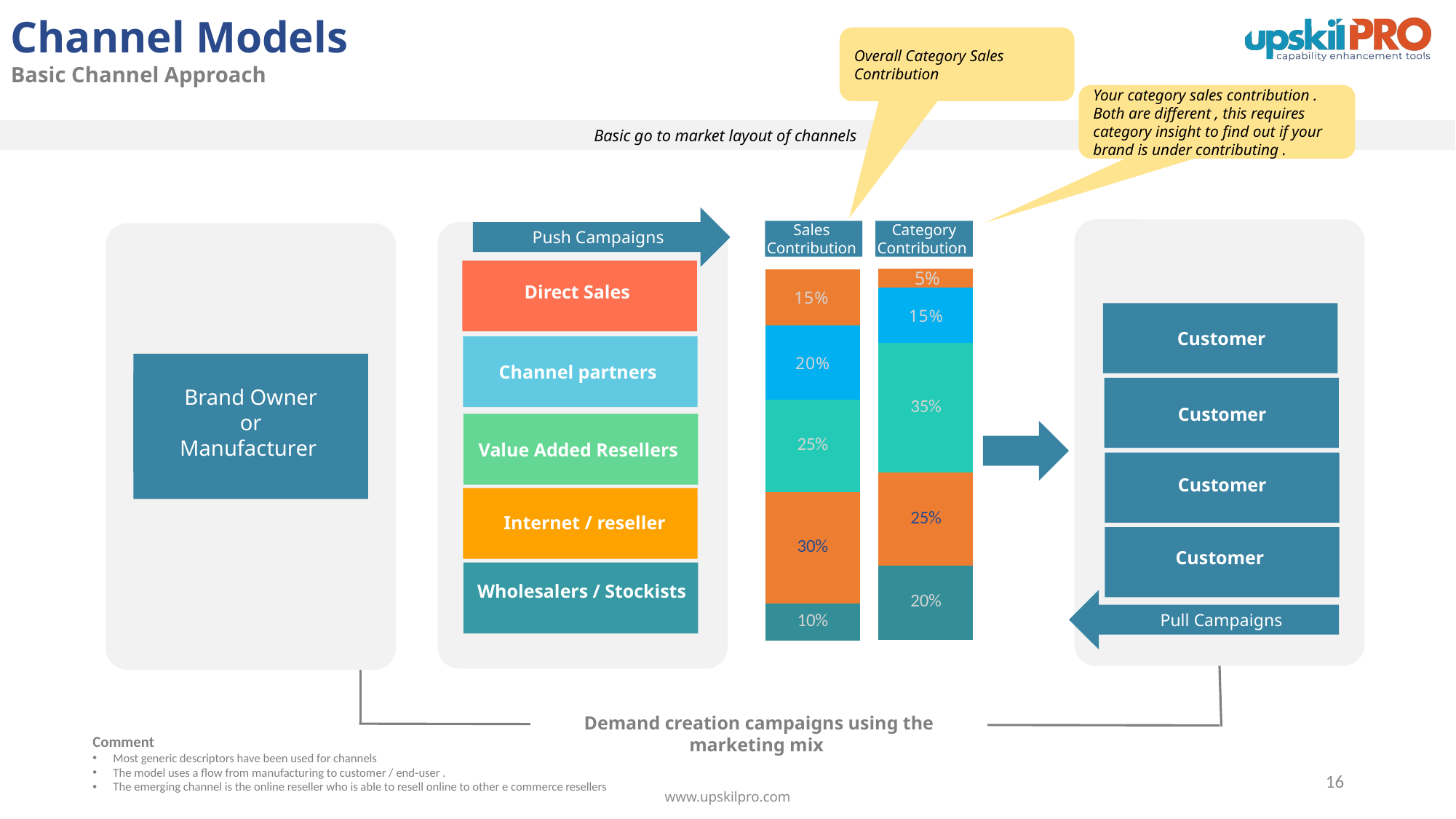
How many segments does the Sales Contribution bar contain? 5 What is the total of the segments in the Category Contribution bar? 100% What kind of chart is used to show the Sales Contribution and Category Contribution figures? stacked bar chart In the Sales Contribution bar, which segment has the largest value? 30% (the segment aligned with Internet / reseller) What is the difference between the Sales Contribution and Category Contribution values for the segment aligned with Value Added Resellers? 10% In the Category Contribution bar, which segment has the smallest value? 5% (the segment aligned with Direct Sales) For the segment aligned with Channel partners, which is larger: the Sales Contribution value or the Category Contribution value? Sales Contribution In the Category Contribution bar, what is the value of the bottom segment (aligned with Wholesalers / Stockists)? 20% In the Category Contribution bar, which segment has the largest value? 35% (the segment aligned with Value Added Resellers) In the Category Contribution bar, what is the value of the top segment (aligned with Direct Sales)? 5% In the Sales Contribution bar, what is the value of the top segment (aligned with Direct Sales)? 15% In the Sales Contribution bar, what is the value of the bottom segment (aligned with Wholesalers / Stockists)? 10%